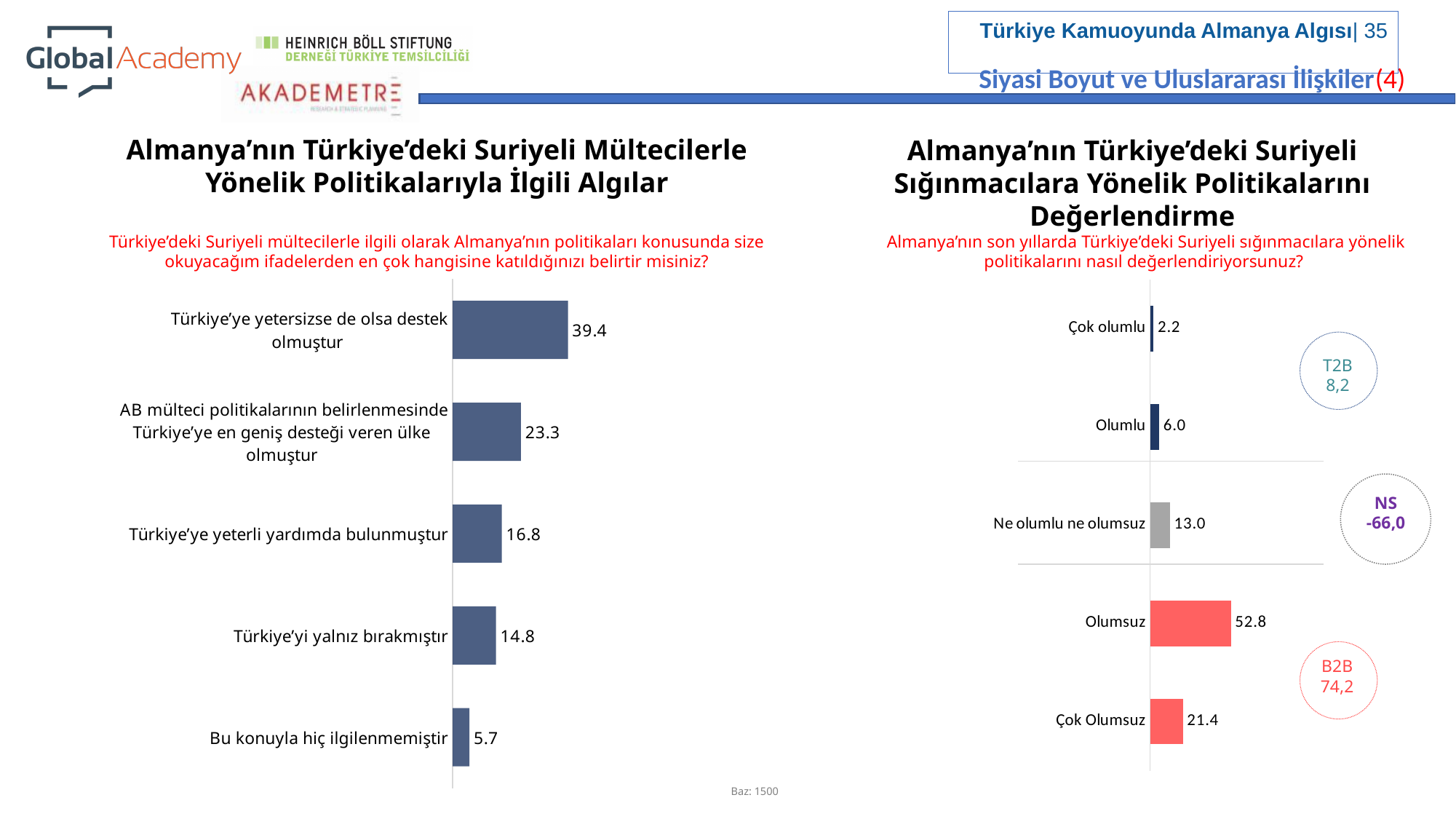
In the right chart, what value is shown in the B2B circle? 74,2 In the right chart (Almanya'nın Türkiye'deki Suriyeli Sığınmacılara Yönelik Politikalarını Değerlendirme), what is the value for 'Olumsuz'? 52.8 In the left chart (Almanya'nın Türkiye'deki Suriyeli Mültecilerle Yönelik Politikalarıyla İlgili Algılar), what is the value for 'Türkiye'ye yetersizse de olsa destek olmuştur'? 39.4 In the right chart, what is the value for 'Ne olumlu ne olumsuz'? 13.0 In the left chart, what is the difference between 'Türkiye'ye yetersizse de olsa destek olmuştur' and 'AB mülteci politikalarının belirlenmesinde Türkiye'ye en geniş desteği veren ülke olmuştur'? 16.1 In the left chart, how many categories are shown? 5 In the right chart, which is larger: 'Çok Olumsuz' or 'Olumlu'? Çok Olumsuz In the left chart, what is the value for 'Türkiye'yi yalnız bırakmıştır'? 14.8 In the right chart, which category has the highest value? Olumsuz In the right chart, what is the difference between 'Olumsuz' and 'Çok Olumsuz'? 31.4 In the left chart, which category has the lowest value? Bu konuyla hiç ilgilenmemiştir What type of chart is the left chart? Bar chart